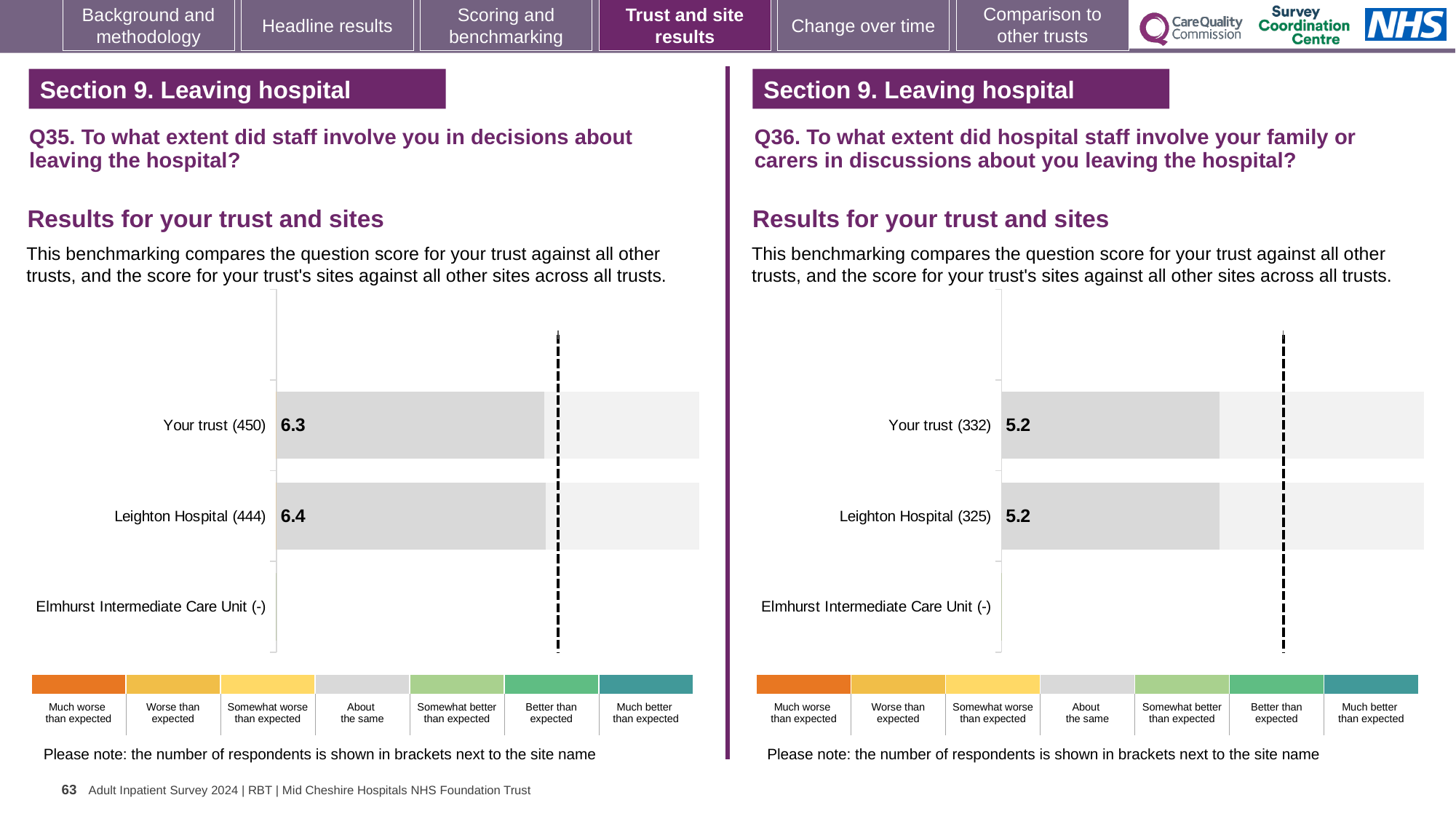
On the Q35 chart (left), what is the difference between the Leighton Hospital score and the Your trust score? 0.1 How many benchmark bands are shown in the colour key below the Q36 chart (right)? 7 On the Q36 chart (right), what is the difference between the Your trust score and the Leighton Hospital score? 0 How many categories (sites) are listed on the Q35 chart (left)? 3 On the Q35 chart (left), what is the score for Leighton Hospital? 6.4 On the Q35 chart (left), which site has no score shown? Elmhurst Intermediate Care Unit On the Q35 chart (left), how many respondents are shown in brackets for Your trust? 450 On the Q35 chart (left), what is the score for Your trust? 6.3 On the Q36 chart (right), what is the score for Leighton Hospital? 5.2 What kind of chart is the Q36 chart (right)? Bar chart On the Q36 chart (right), what is the score for Your trust? 5.2 On the Q36 chart (right), how many respondents are shown in brackets for Leighton Hospital? 325